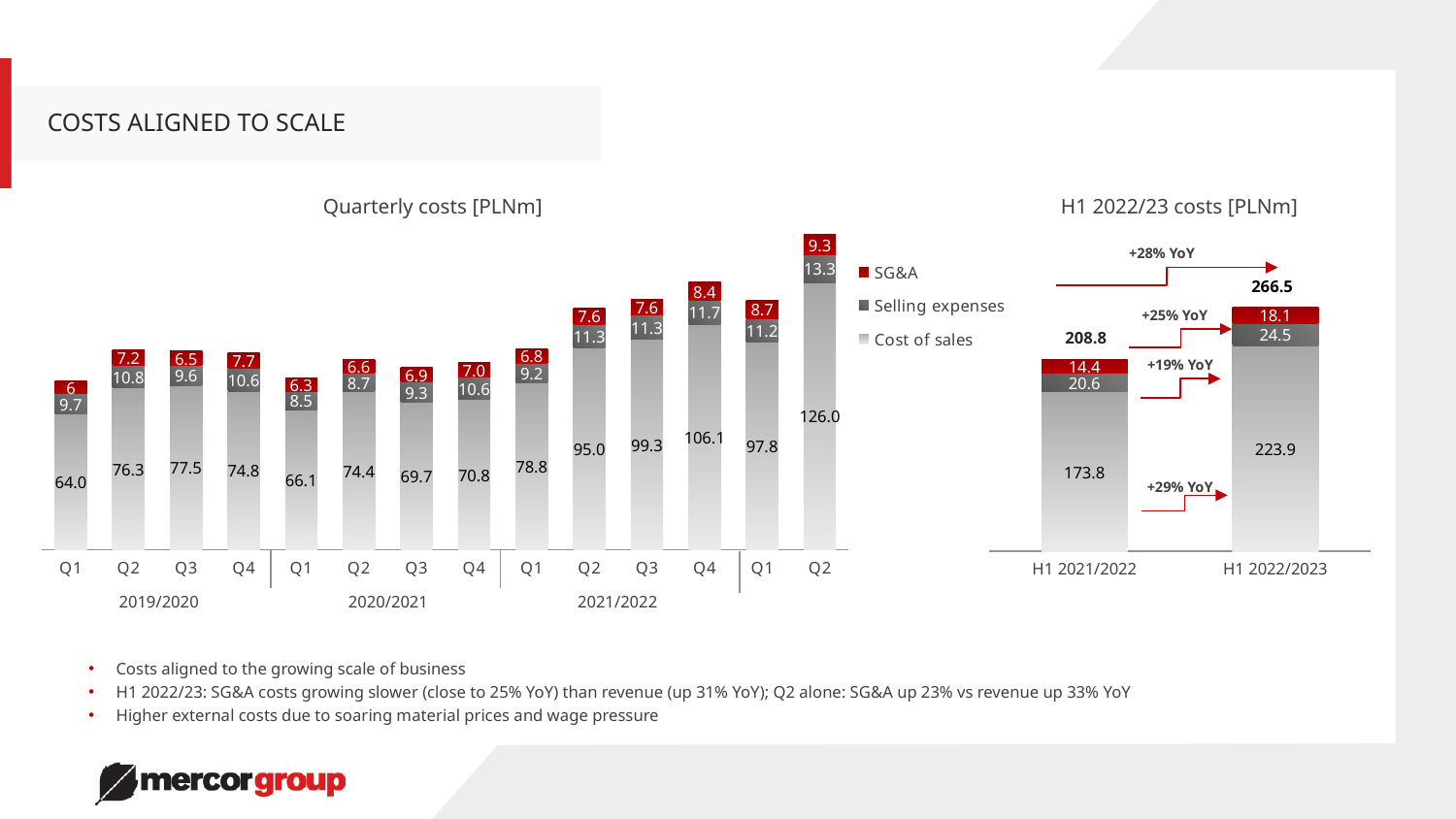
In the H1 2022/23 costs chart, what is the total cost for H1 2022/2023? 266.5 How many quarterly bars are shown in the Quarterly costs chart? 14 In the H1 2022/23 costs chart, what is the selling expenses value for H1 2021/2022? 20.6 In the Quarterly costs chart, which quarter has the highest cost of sales? Q2 (the rightmost bar) In the Quarterly costs chart, what is the SG&A value for Q2 2019/2020? 7.2 In the H1 2022/23 costs chart, what YoY growth is shown for cost of sales? +29% YoY In the Quarterly costs chart, is the cost of sales higher in Q1 2020/2021 or Q1 2021/2022? Q1 2021/2022 In the Quarterly costs chart, which quarter has the lowest cost of sales? Q1 2019/2020 In the Quarterly costs chart, what is the difference in cost of sales between Q3 2021/2022 and Q2 2021/2022? 4.3 How many series does the legend list for the cost charts? 3 In the Quarterly costs chart, what is the cost of sales value for Q4 2021/2022? 106.1 What type of chart is the H1 2022/23 costs chart? Stacked bar chart